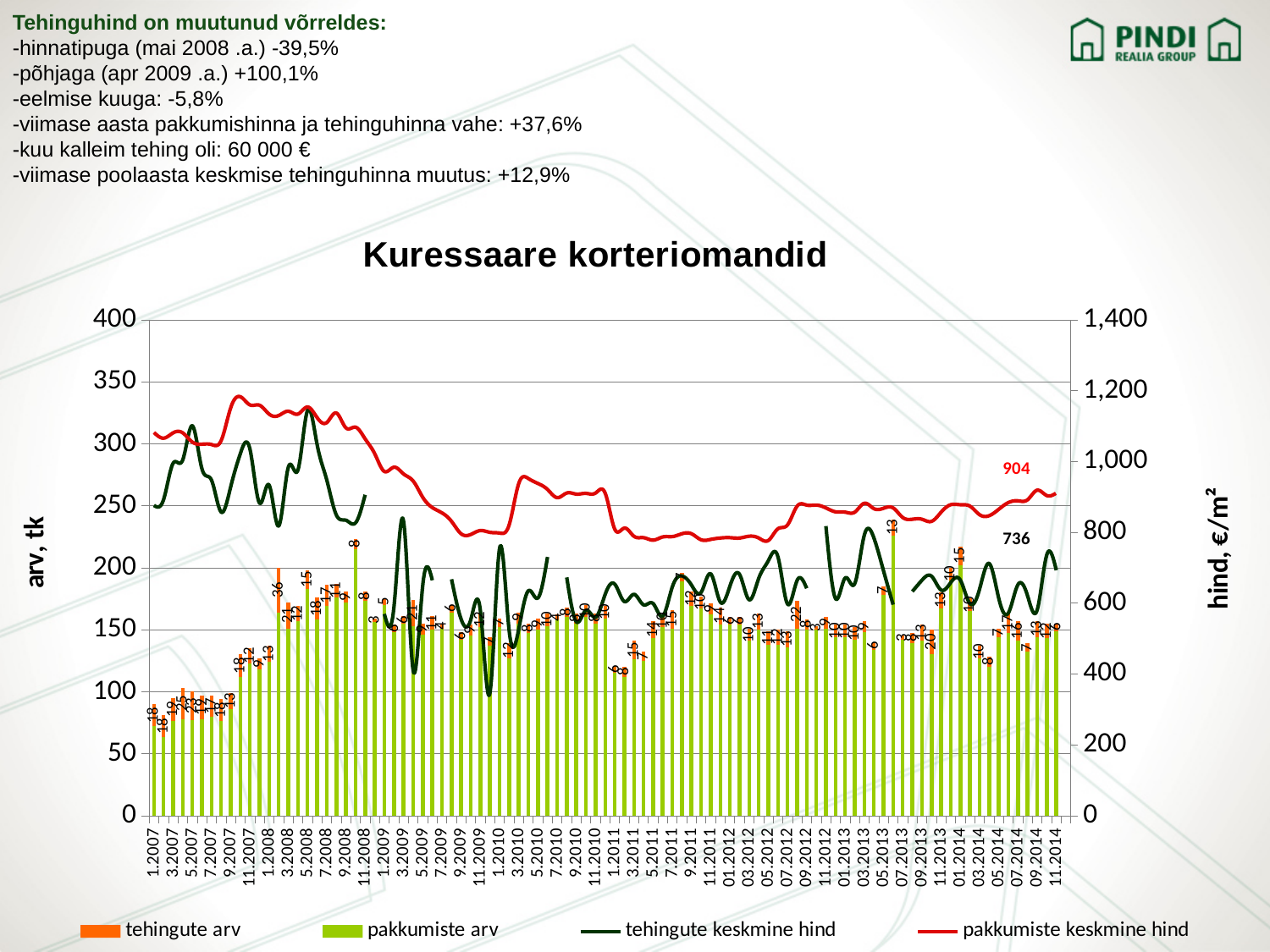
How many series does the legend list? 4 What kind of chart is shown on the slide? A combined bar and line chart Which series is drawn as the red line? pakkumiste keskmine hind What is the latest labelled value of the tehingute keskmine hind line? 736 What is the title of the chart? Kuressaare korteriomandid What is the latest labelled value of the pakkumiste keskmine hind line? 904 What is the difference between the labelled values 904 (pakkumiste keskmine hind) and 736 (tehingute keskmine hind)? 168 Is the pakkumiste arv bar at 11.2008 greater or less than 200? less Does the pakkumiste keskmine hind line rise or fall between 1.2008 and 11.2009? fall At the end of the chart, which is larger: pakkumiste keskmine hind or tehingute keskmine hind? pakkumiste keskmine hind Is the pakkumiste keskmine hind value at 1.2008 greater or less than 1,000? greater Is the tehingute keskmine hind value at 11.2009 greater or less than 400? greater